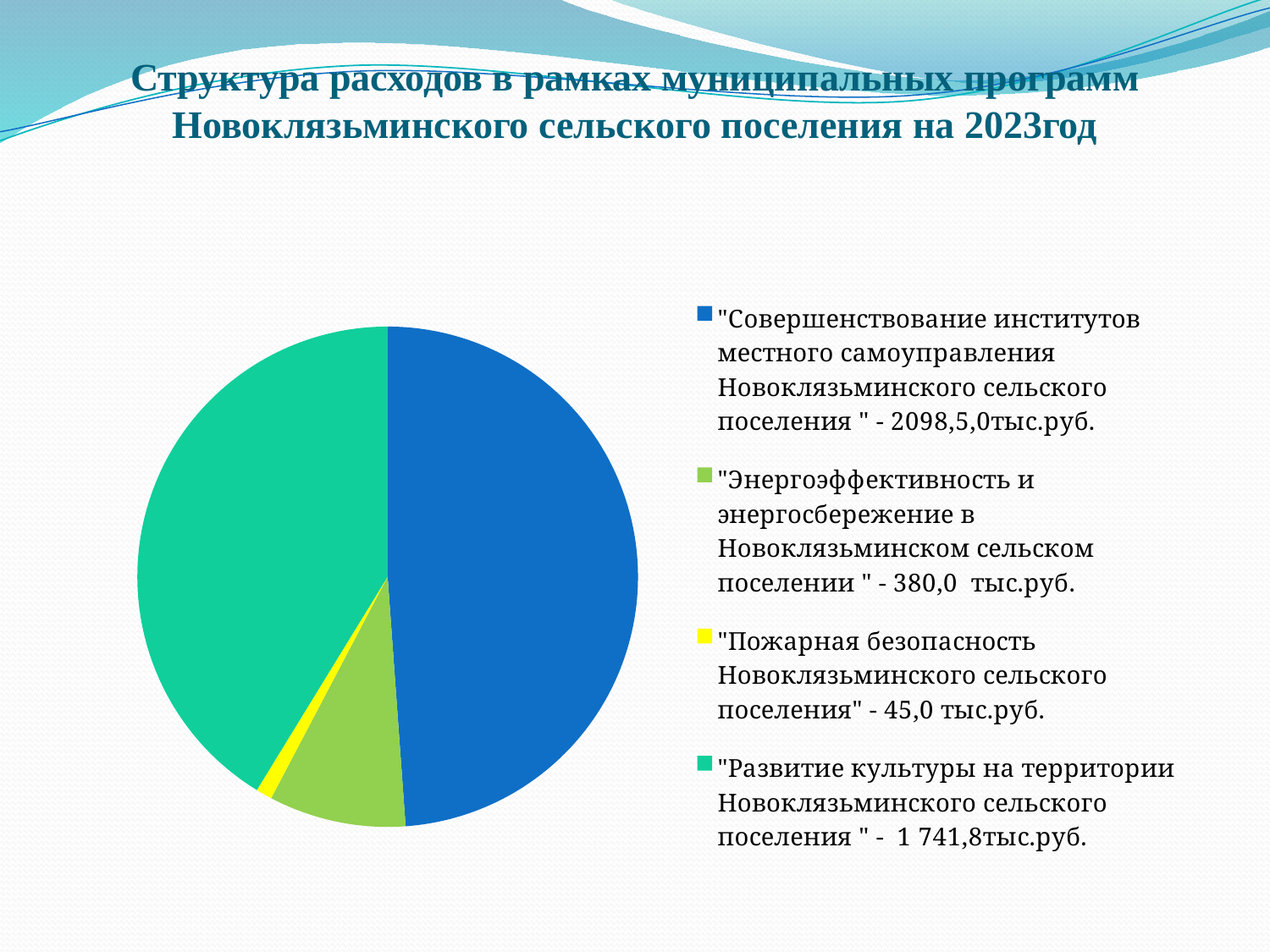
How many entries does the legend list? 4 What amount is given for the programme "Энергоэффективность и энергосбережение в Новоклязьминском сельском поселении"? 380,0 тыс.руб. What year does the slide title say the expenditure structure refers to? 2023 What amount is given for the programme "Пожарная безопасность Новоклязьминского сельского поселения"? 45,0 тыс.руб. How many slices does the pie chart have? 4 Which programme has the smallest share of expenditure in the pie chart? "Пожарная безопасность Новоклязьминского сельского поселения" Which programme has the largest share of expenditure in the pie chart? "Совершенствование институтов местного самоуправления Новоклязьминского сельского поселения" By how much does the expenditure on "Энергоэффективность и энергосбережение" exceed that on "Пожарная безопасность"? 335,0 тыс.руб. What colour is the slice for "Пожарная безопасность Новоклязьминского сельского поселения"? yellow Which is larger: the expenditure on "Развитие культуры" or on "Энергоэффективность и энергосбережение"? "Развитие культуры на территории Новоклязьминского сельского поселения" What kind of chart is shown on the slide? pie chart What amount is given for the programme "Развитие культуры на территории Новоклязьминского сельского поселения"? 1 741,8 тыс.руб.